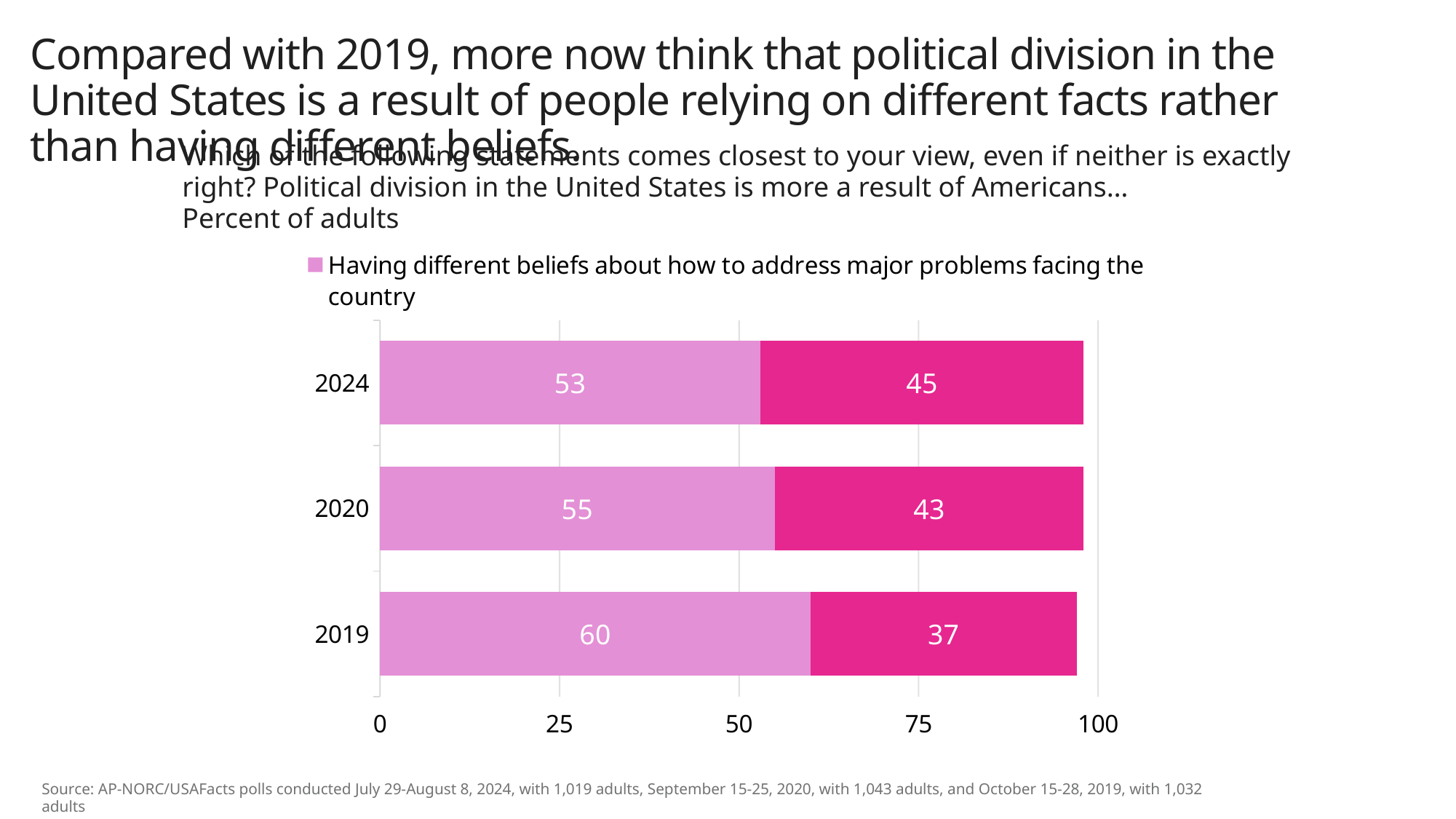
What is the difference between the 2019 and 2024 values for 'Having different beliefs about how to address major problems facing the country'? 7 What is the total of the two segments in the 2019 bar? 97 What kind of chart is shown on the slide? Stacked bar chart Which year has the lowest value for 'Having different beliefs about how to address major problems facing the country'? 2024 How many years are shown on the chart? 3 What is the value for 'Having different beliefs about how to address major problems facing the country' in 2024? 53 Does the value for 'Having different beliefs about how to address major problems facing the country' rise or fall from 2019 to 2024? Fall Which year has the highest value for 'Having different beliefs about how to address major problems facing the country'? 2019 What is the value of the darker pink segment of the 2019 bar? 37 What is the value of the darker pink segment of the 2020 bar? 43 What is the value for 'Having different beliefs about how to address major problems facing the country' in 2019? 60 In 2024, which segment is larger: the light pink 'Having different beliefs' segment or the darker pink segment? Having different beliefs about how to address major problems facing the country